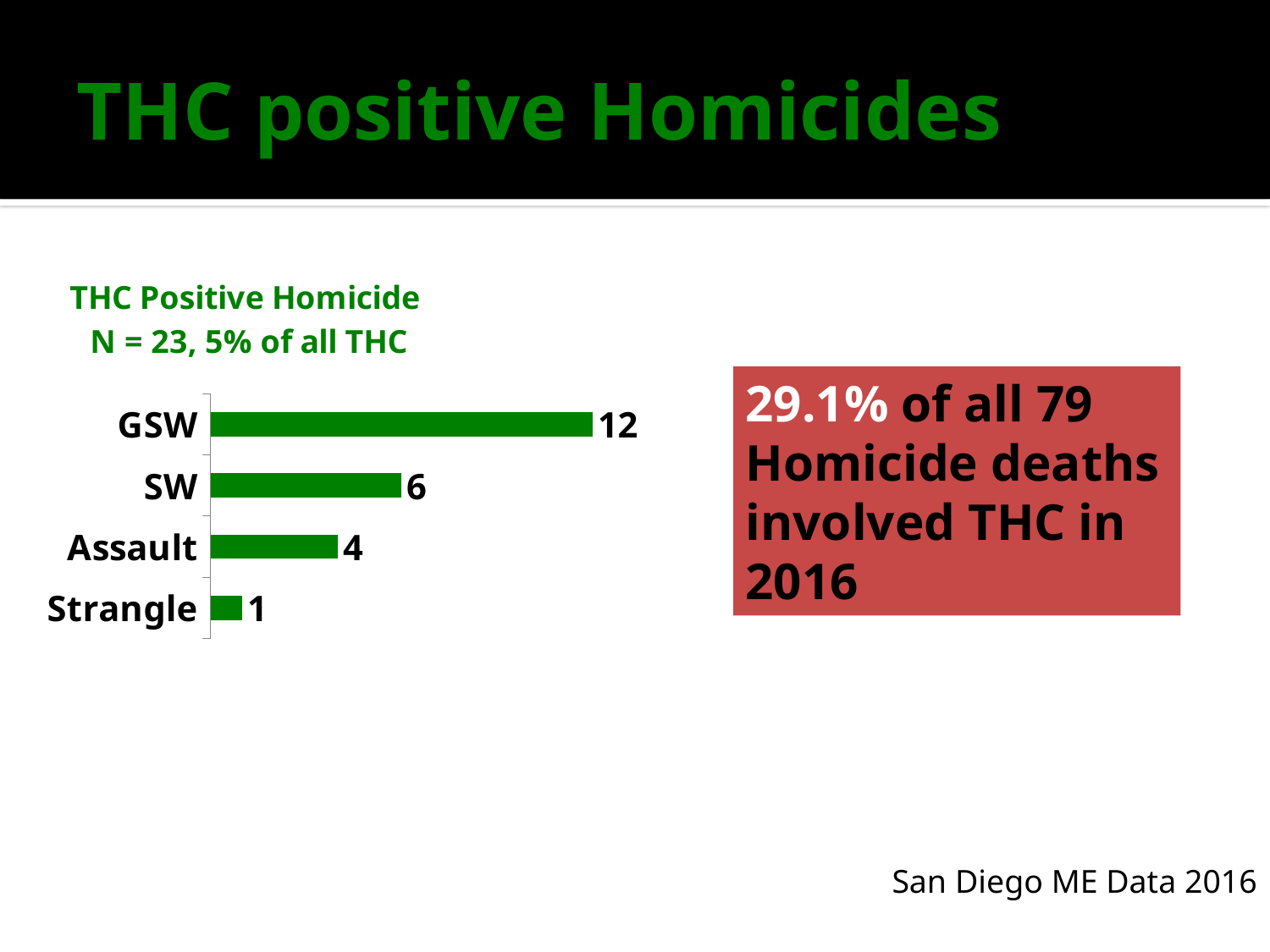
How many categories are shown in the chart? 4 Which category has the highest value? GSW What is the title of the chart? THC Positive Homicide N = 23, 5% of all THC What is the value for Assault? 4 What is the difference between the values for GSW and SW? 6 Which is larger, the value for SW or the value for Assault? SW What is the value for Strangle? 1 What is the value for SW? 6 What is the difference between the values for Assault and Strangle? 3 Which category has the lowest value? Strangle What kind of chart is shown on the slide? Bar chart What is the value for GSW? 12